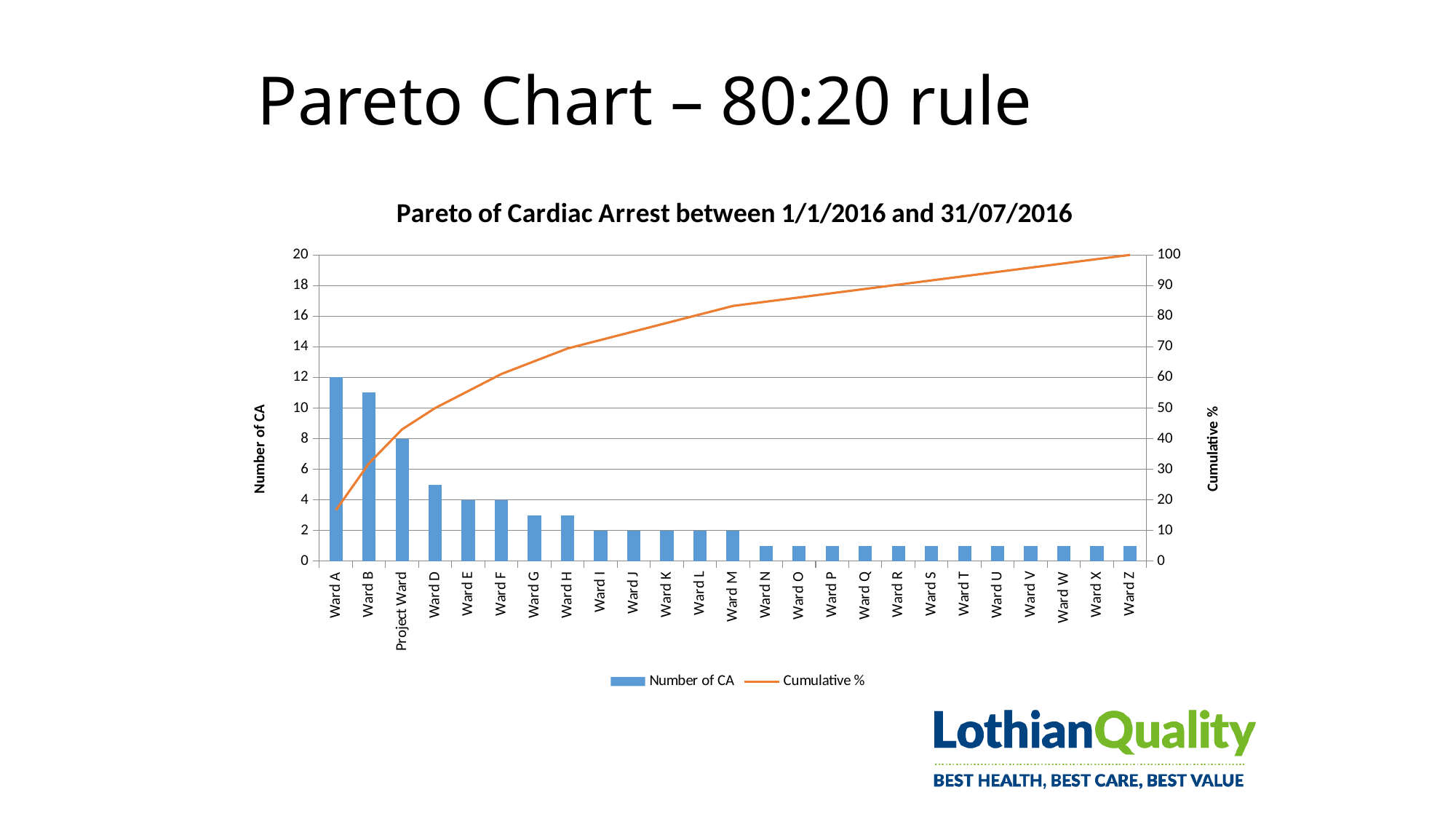
What is the difference in Number of CA between Ward A and Project Ward? 4 Which ward has the highest Number of CA? Ward A How many wards are shown on the x axis? 25 Is the Number of CA for Ward B greater or less than 10? greater Which has a higher Number of CA, Ward A or Ward B? Ward A What is the Number of CA for Ward A? 12 What type of chart is shown on the slide? Combination bar and line chart What is the Number of CA for Ward E? 4 What is the Number of CA for Project Ward? 8 What is the title of the chart? Pareto of Cardiac Arrest between 1/1/2016 and 31/07/2016 How many series does the legend list? 2 Is the Cumulative % at Ward M greater or less than 80? greater